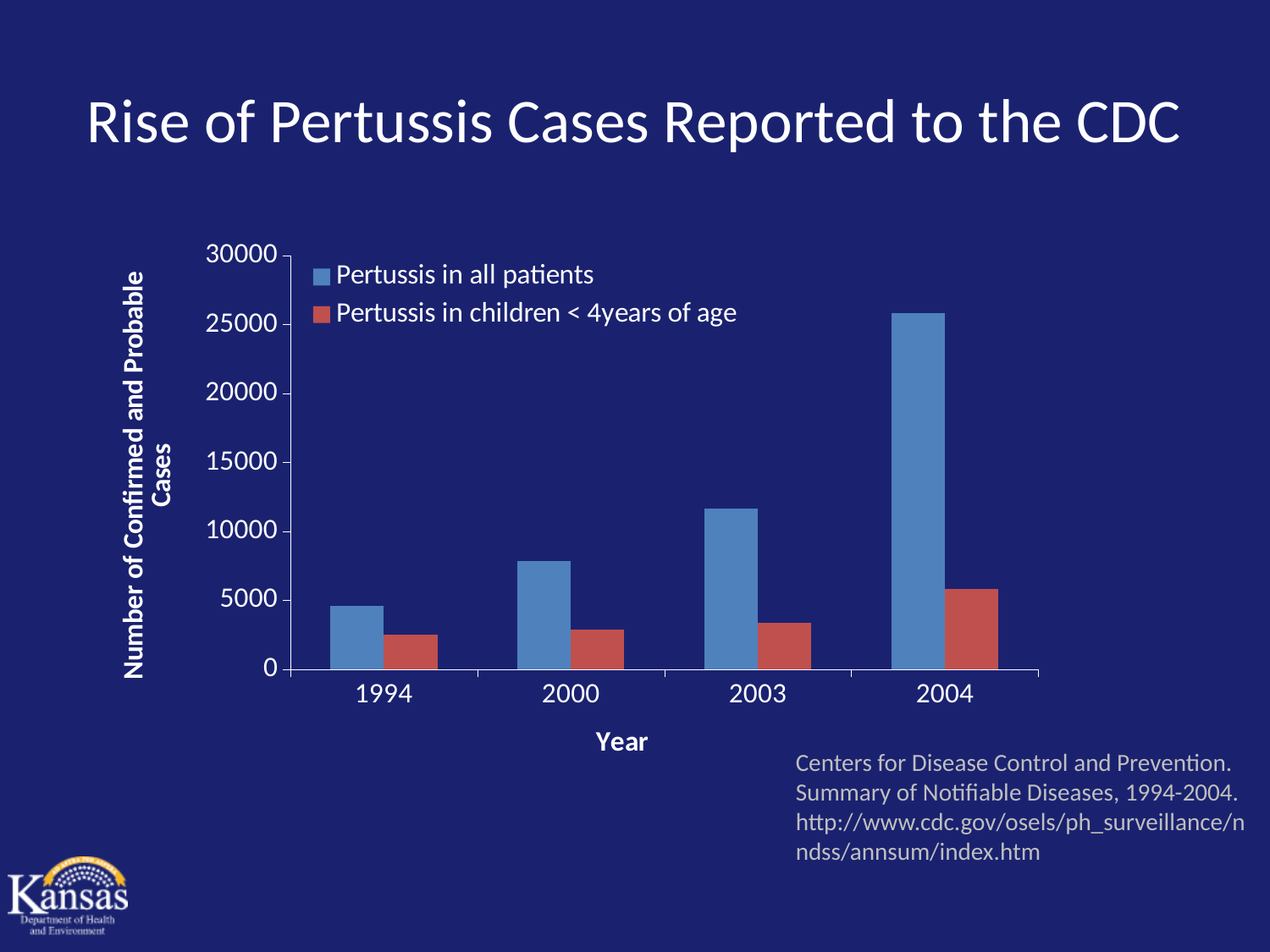
Is the value for Pertussis in all patients in 2004 greater or less than 20000? greater In which year is the value for Pertussis in all patients lowest? 1994 How many years are shown on the x axis? 4 Which is larger: Pertussis in all patients in 2003 or in 2004? 2004 In which year is the value for Pertussis in children < 4years of age highest? 2004 Is the value for Pertussis in children < 4years of age in 2004 greater or less than 5000? greater In which year is the value for Pertussis in all patients highest? 2004 Is the value for Pertussis in all patients in 2000 greater or less than 10000? less What kind of chart is shown on the slide? bar chart Do the values for Pertussis in all patients rise or fall from 1994 to 2004? rise How many series does the legend list? 2